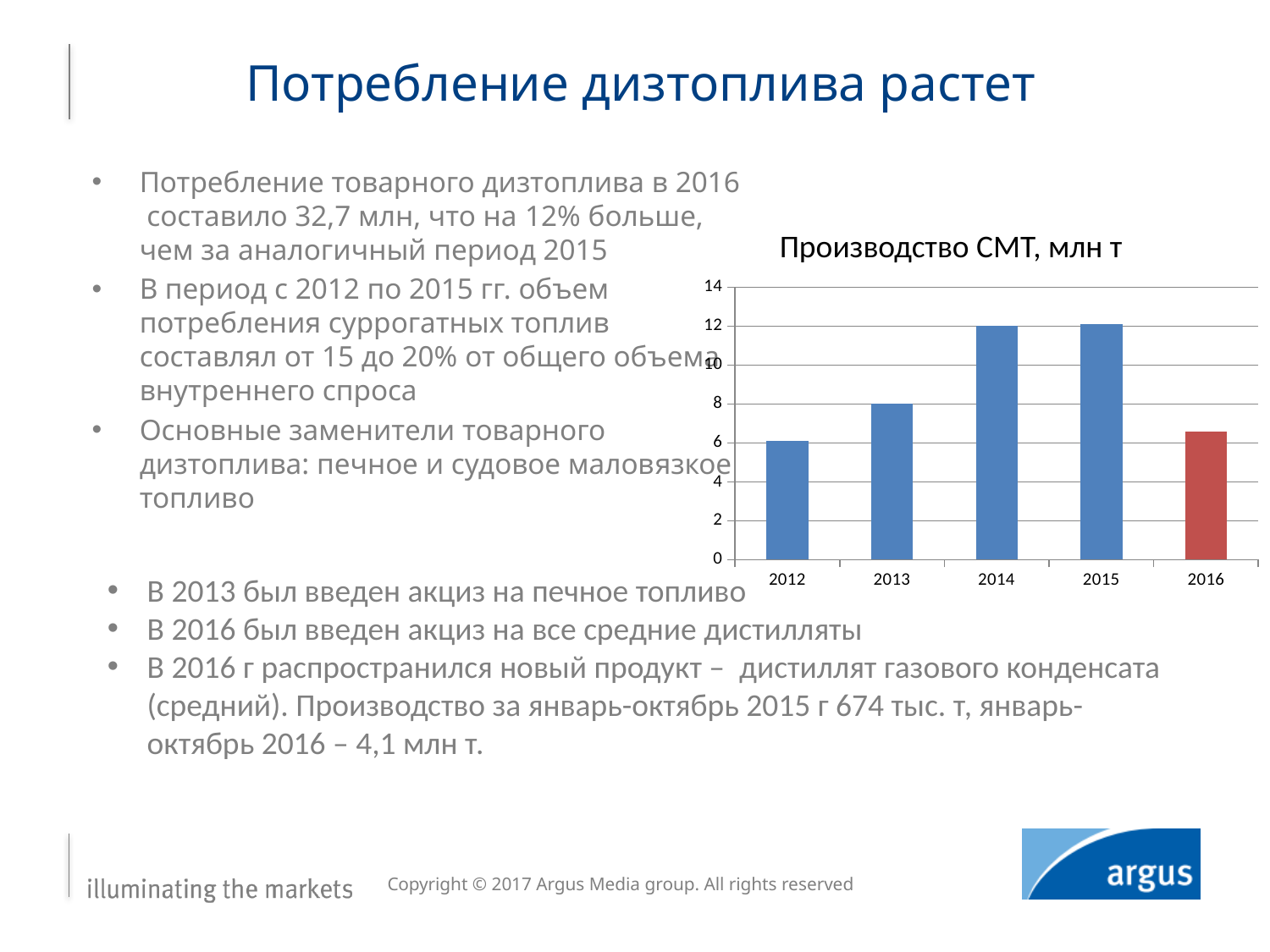
How many years are shown on the x axis of the chart? 5 Which year's bar is coloured red instead of blue? 2016 What is the title of the chart? Производство СМТ, млн т Is the value for 2012 greater or less than 8? less Which is larger, the value for 2014 or the value for 2012? 2014 Do the values rise or fall from 2012 to 2015? rise What kind of chart is shown on the slide? bar chart Which is larger, the value for 2013 or the value for 2016? 2013 Is the value for 2014 greater or less than 10? greater Is the value for 2015 greater or less than 10? greater